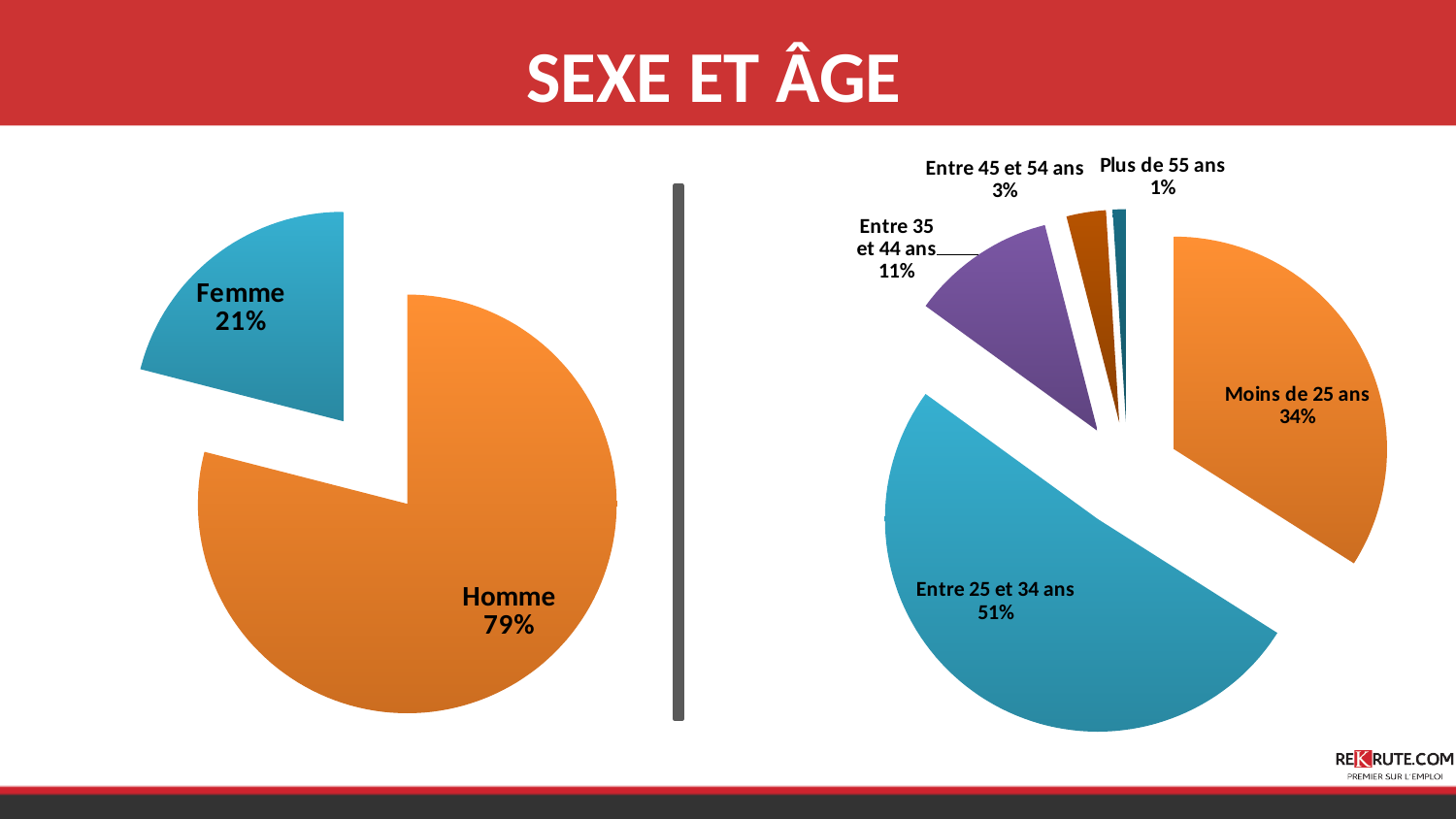
In the right pie chart, what percentage is shown for Entre 25 et 34 ans? 51% What kind of chart is the chart on the right of the slide? Pie chart In the right pie chart, what percentage is shown for Entre 35 et 44 ans? 11% In the right pie chart, which age group has the smallest share? Plus de 55 ans In the right pie chart, which age group has the largest share? Entre 25 et 34 ans In the right pie chart, how many age categories are shown? 5 In the right pie chart, which is larger: Entre 45 et 54 ans or Entre 35 et 44 ans? Entre 35 et 44 ans In the left pie chart, how many slices are there? 2 In the right pie chart, what percentage is shown for Moins de 25 ans? 34% In the left pie chart, what is the difference in percentage points between Homme and Femme? 58 In the left pie chart, what percentage is shown for Femme? 21% In the left pie chart, what percentage is shown for Homme? 79%